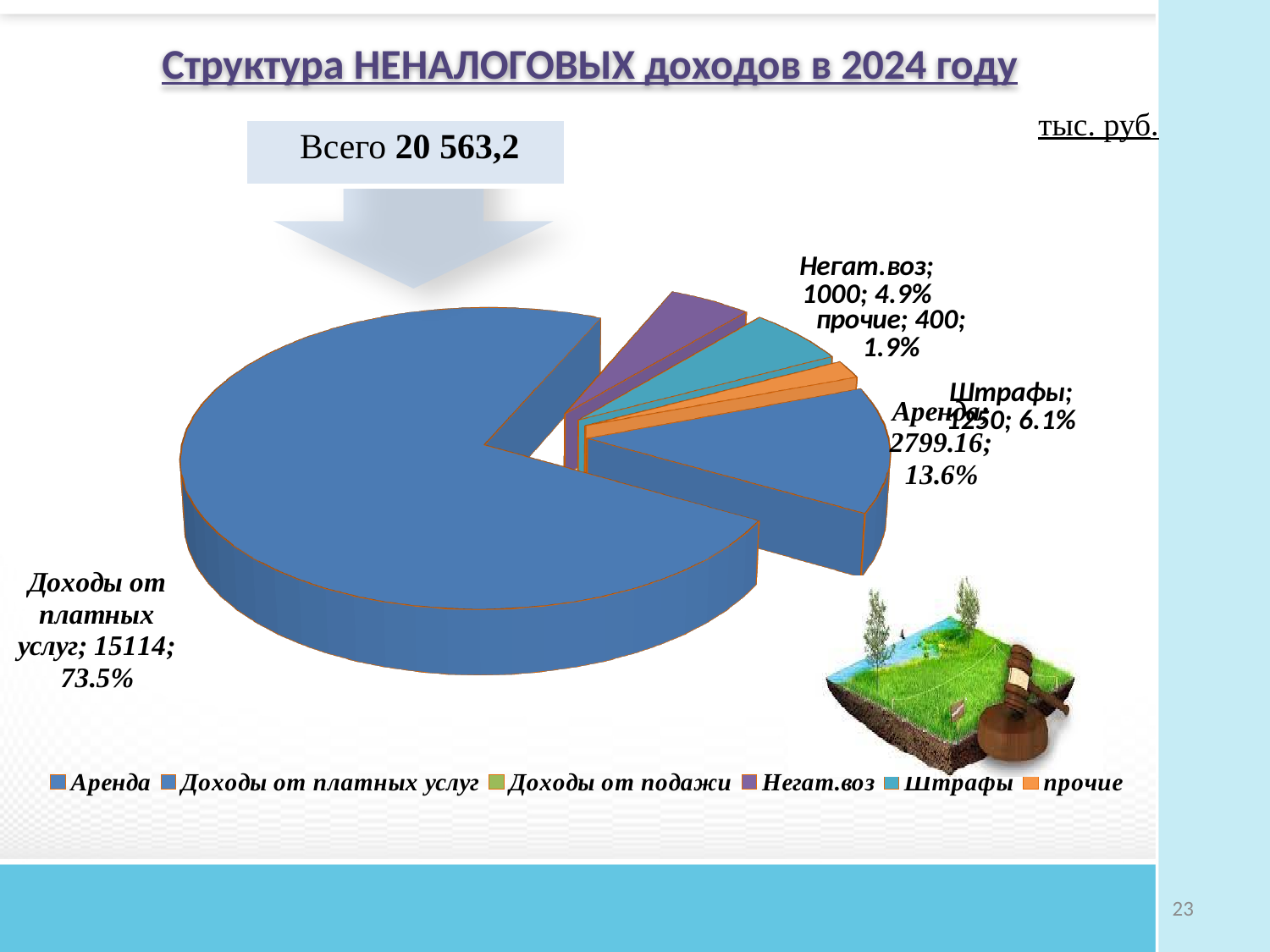
Which category has the largest slice of the pie? Доходы от платных услуг Which is larger, the value for Аренда or the value for Штрафы? Аренда What is the difference between the values for Штрафы and Негат.воз? 250 What is the value for Негат.воз? 1000 What share of the pie does Доходы от платных услуг take? 73.5% Which labelled category has the smallest slice of the pie? прочие How many entries does the legend list? 6 What kind of chart is shown on the slide? pie chart What is the value for Аренда? 2799.16 What is the value for Доходы от платных услуг? 15114 What percentage is shown for прочие? 1.9% What percentage is shown for Штрафы? 6.1%